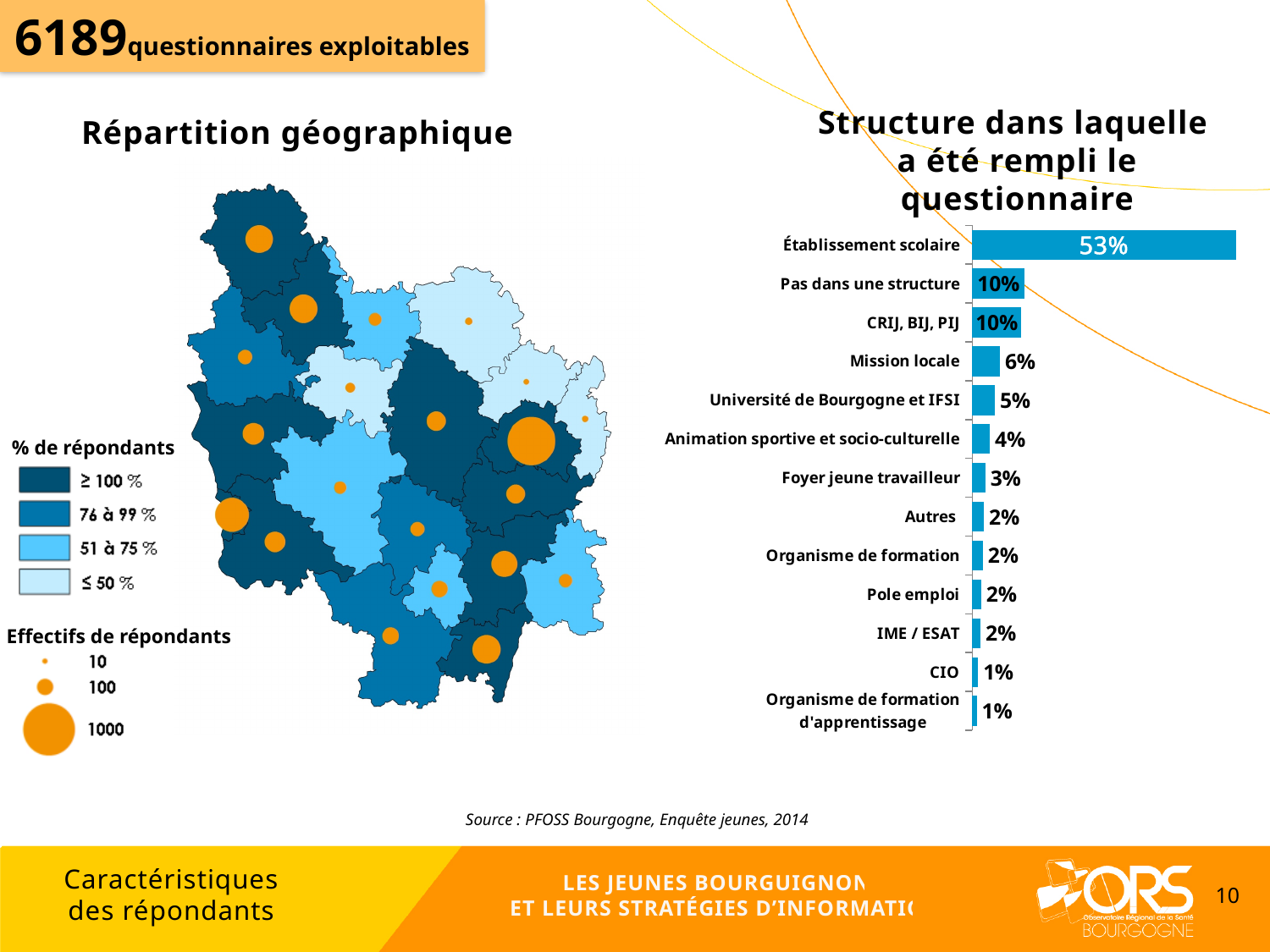
In the chart 'Structure dans laquelle a été rempli le questionnaire', what is the value for CIO? 1% In the chart 'Structure dans laquelle a été rempli le questionnaire', what is the difference between Mission locale and Animation sportive et socio-culturelle? 2 percentage points What kind of chart is 'Structure dans laquelle a été rempli le questionnaire'? Bar chart In the chart 'Structure dans laquelle a été rempli le questionnaire', which structure has the highest percentage? Établissement scolaire In the chart 'Structure dans laquelle a été rempli le questionnaire', what is the value for Foyer jeune travailleur? 3% In the chart 'Structure dans laquelle a été rempli le questionnaire', what is the value for Mission locale? 6% What is the source cited below the chart 'Structure dans laquelle a été rempli le questionnaire'? PFOSS Bourgogne, Enquête jeunes, 2014 In the chart 'Structure dans laquelle a été rempli le questionnaire', what percentage is shown for Établissement scolaire? 53% In the chart 'Structure dans laquelle a été rempli le questionnaire', what is the difference between Établissement scolaire and Pas dans une structure? 43 percentage points How many structures (categories) are listed in the chart 'Structure dans laquelle a été rempli le questionnaire'? 13 In the chart 'Structure dans laquelle a été rempli le questionnaire', what is the value for Université de Bourgogne et IFSI? 5% In the chart 'Structure dans laquelle a été rempli le questionnaire', which is larger: Mission locale or Foyer jeune travailleur? Mission locale